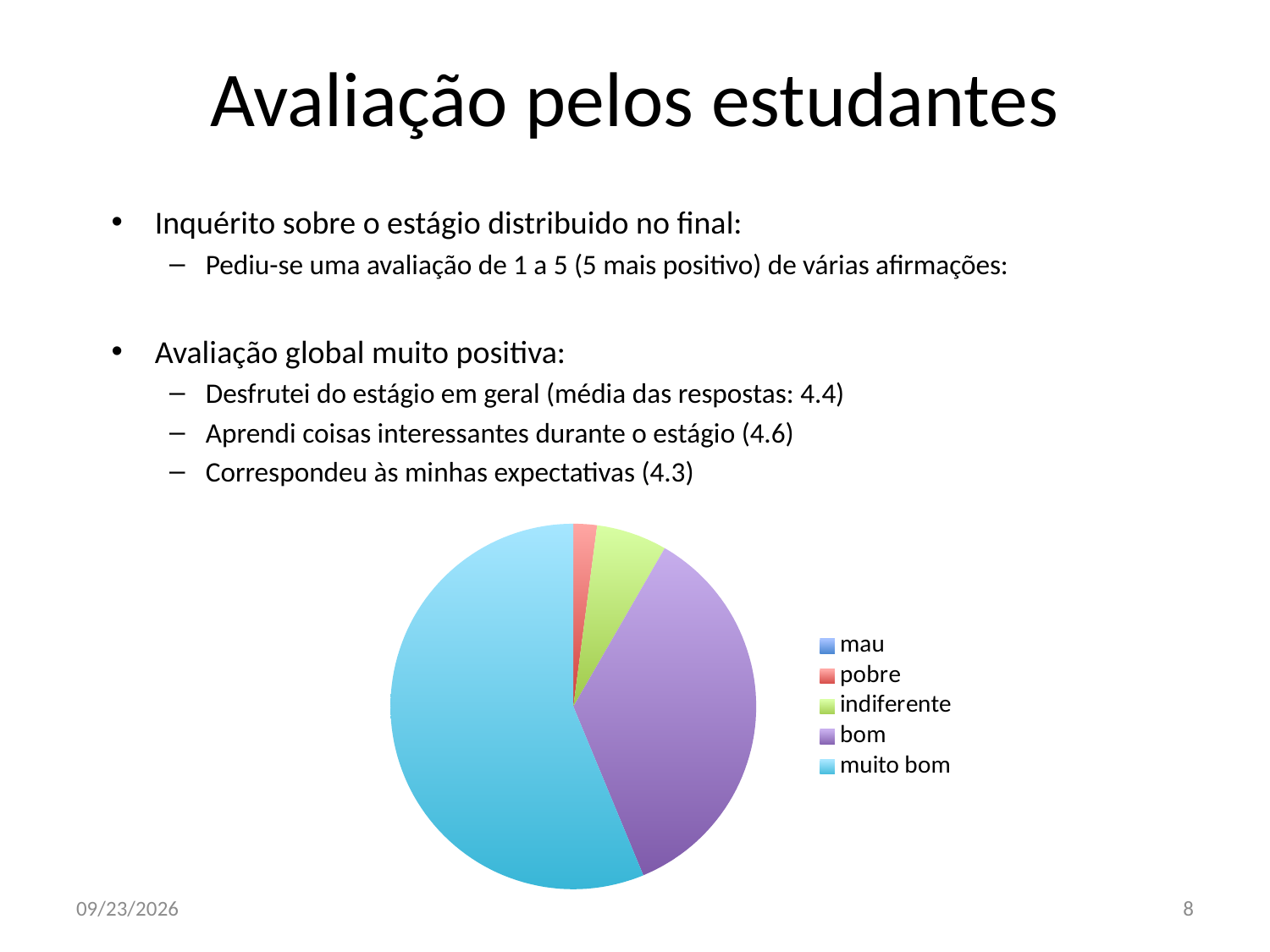
Which category has the largest slice of the pie chart? muito bom Which slice is larger in the pie chart, "indiferente" or "bom"? bom How many categories does the legend of the pie chart list? 5 Which slice is larger in the pie chart, "pobre" or "indiferente"? indiferente Which slice is larger in the pie chart, "bom" or "muito bom"? muito bom What colour is the "muito bom" slice in the pie chart? light blue What kind of chart is shown on the slide? pie chart Which category is listed first in the legend of the pie chart? mau Which category is shown in purple in the pie chart? bom